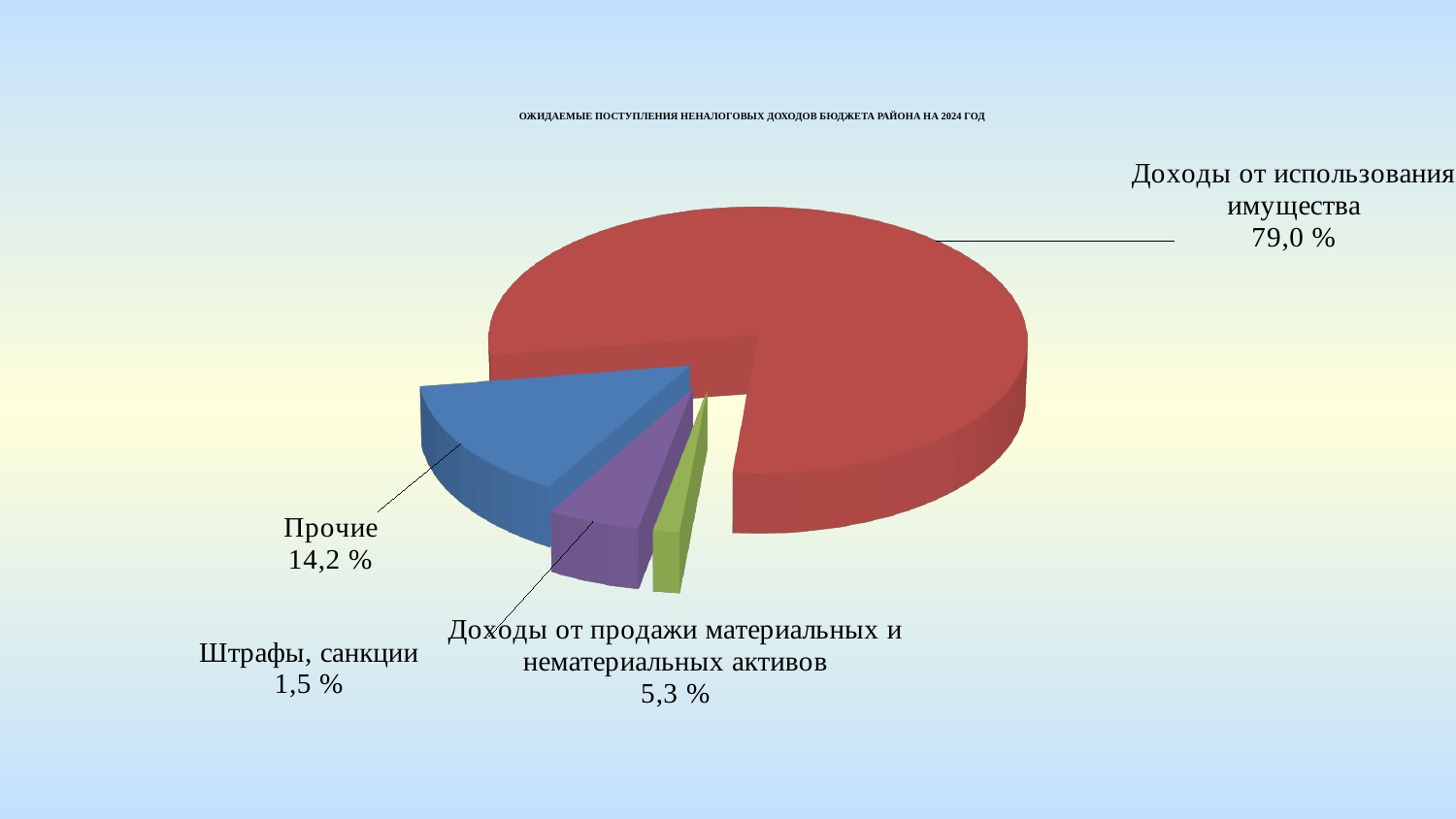
What is the value shown for "Доходы от продажи материальных и нематериальных активов"? 5,3 % What is the difference between the shares of "Доходы от использования имущества" and "Прочие"? 64,8 % Which category has the largest slice of the pie? Доходы от использования имущества What share of the pie does "Доходы от использования имущества" have? 79,0 % What colour is the slice for "Прочие"? Blue What is the value shown for "Прочие"? 14,2 % What kind of chart is shown on the slide? Pie chart What is the difference between the shares of "Доходы от продажи материальных и нематериальных активов" and "Штрафы, санкции"? 3,8 % What is the value shown for "Штрафы, санкции"? 1,5 % How many slices does the pie chart have? 4 Which category has the smallest slice of the pie? Штрафы, санкции Which is larger: the share of "Прочие" or the share of "Доходы от продажи материальных и нематериальных активов"? Прочие